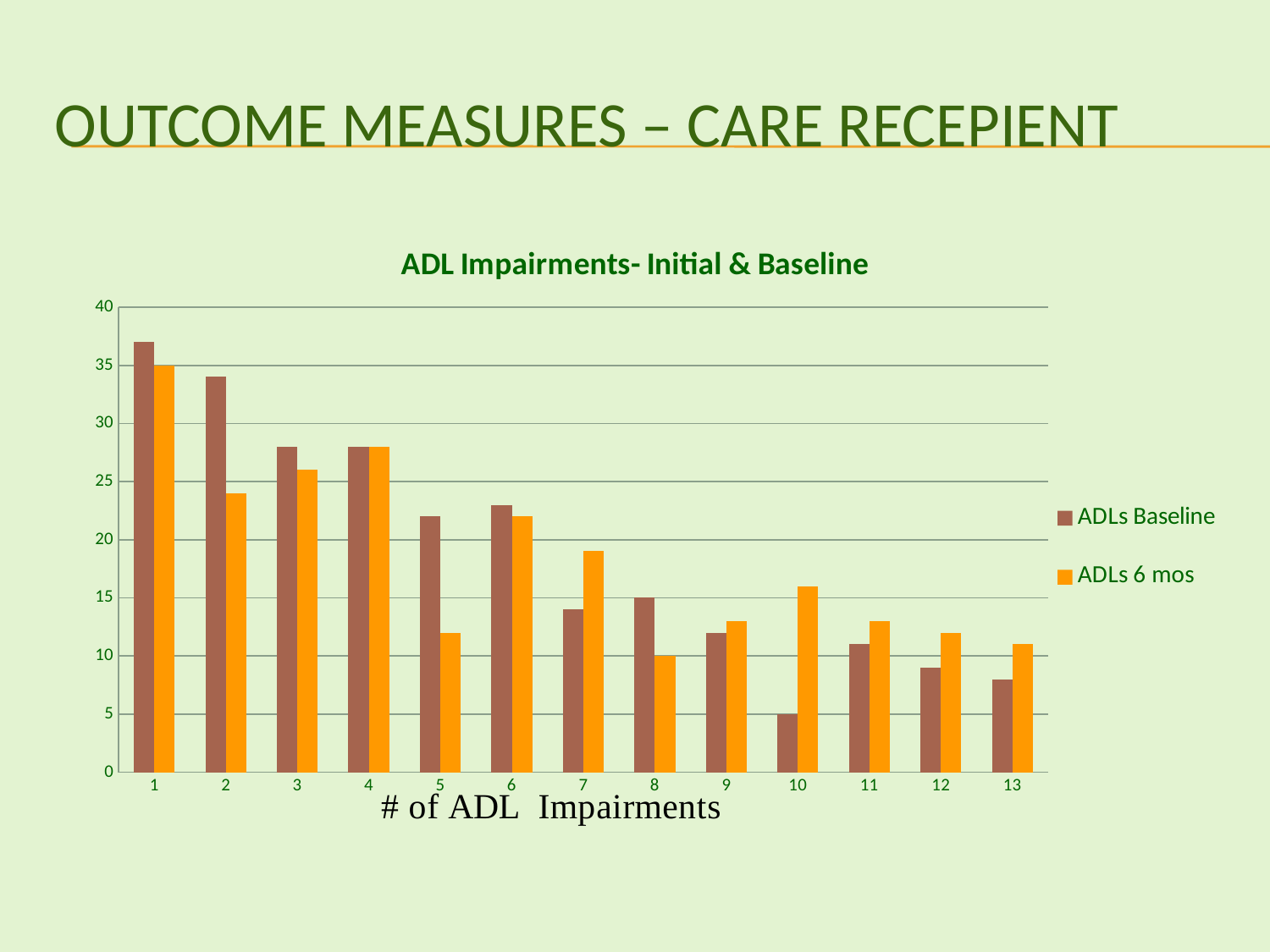
What type of chart is shown on the slide? bar chart Do the ADLs Baseline values generally rise or fall from category 1 to category 13? fall For category 7, which is larger: ADLs Baseline or ADLs 6 mos? ADLs 6 mos Which category has the lowest ADLs Baseline value? 10 What is the ADLs Baseline value for category 10? 5 Which category has the highest ADLs 6 mos value? 1 How many series does the legend list? 2 Which category has the highest ADLs Baseline value? 1 Is the ADLs 6 mos value for category 5 greater or less than 15? less What is the title of the chart? ADL Impairments- Initial & Baseline How many categories are shown on the x axis? 13 Is the ADLs Baseline value for category 2 greater or less than 30? greater